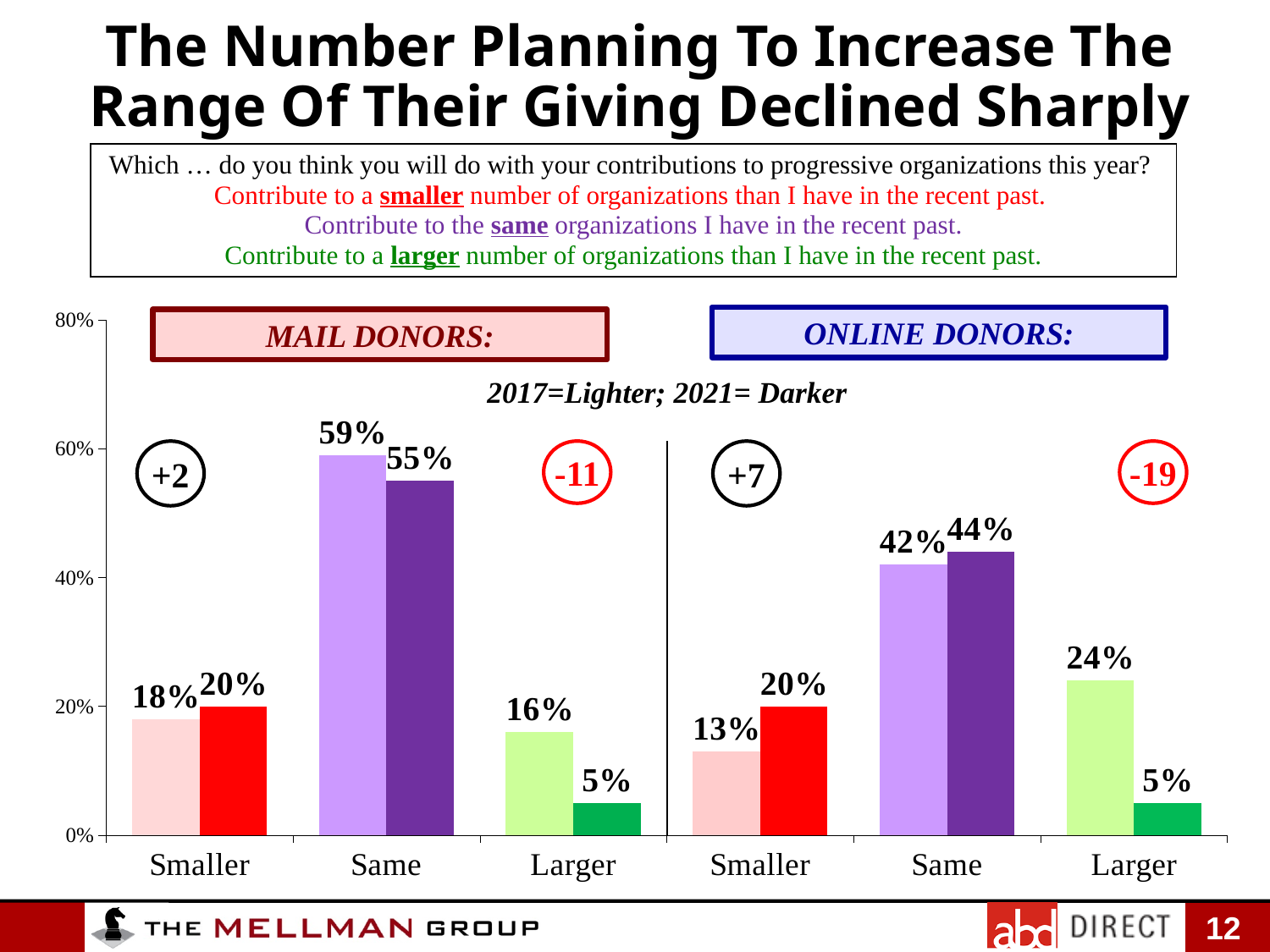
What percentage of online donors said they would contribute to a larger number of organizations in 2017? 24% What is the difference between the 2017 and 2021 percentages for online donors choosing 'Same'? 2% How many response categories are shown on the x axis for each donor group? 3 What percentage of online donors said they would contribute to a smaller number of organizations in 2021? 20% Among mail donors, which response had the highest percentage in 2017? Same Is the 2017 'Same' value for mail donors greater or less than 40%? greater Among online donors, which response had the lowest percentage in 2021? Larger Which is larger: the 2021 'Same' percentage for mail donors or for online donors? Mail donors What type of chart is shown on the slide? Bar chart What percentage of mail donors said they would contribute to the same organizations in 2021? 55% According to the slide, which year do the darker bars represent? 2021 By how many percentage points did the share of mail donors planning to give to a larger number of organizations change from 2017 to 2021? -11